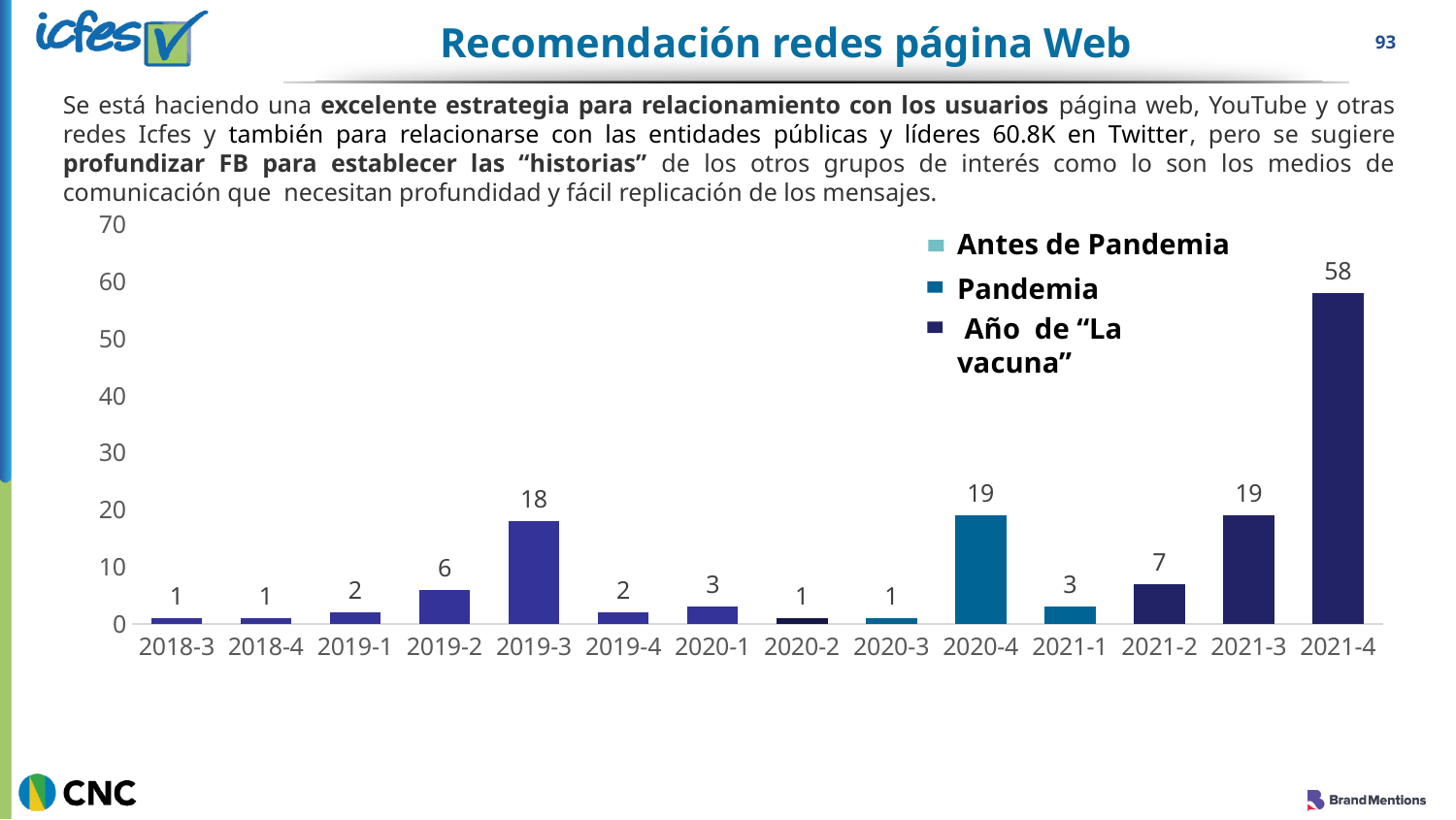
What is the value for 2021-4? 58 How many series does the legend list? 3 What is the difference between the values for 2020-4 and 2021-1? 16 Is the value for 2021-4 greater or less than 50? greater What is the first entry in the chart legend? Antes de Pandemia What kind of chart is shown on the slide? bar chart What is the difference between the values for 2021-4 and 2021-3? 39 How many periods are shown on the x axis? 14 Which period has the highest value? 2021-4 What is the value for 2021-2? 7 What is the value for 2019-3? 18 Which is larger, the value for 2019-2 or the value for 2021-2? 2021-2